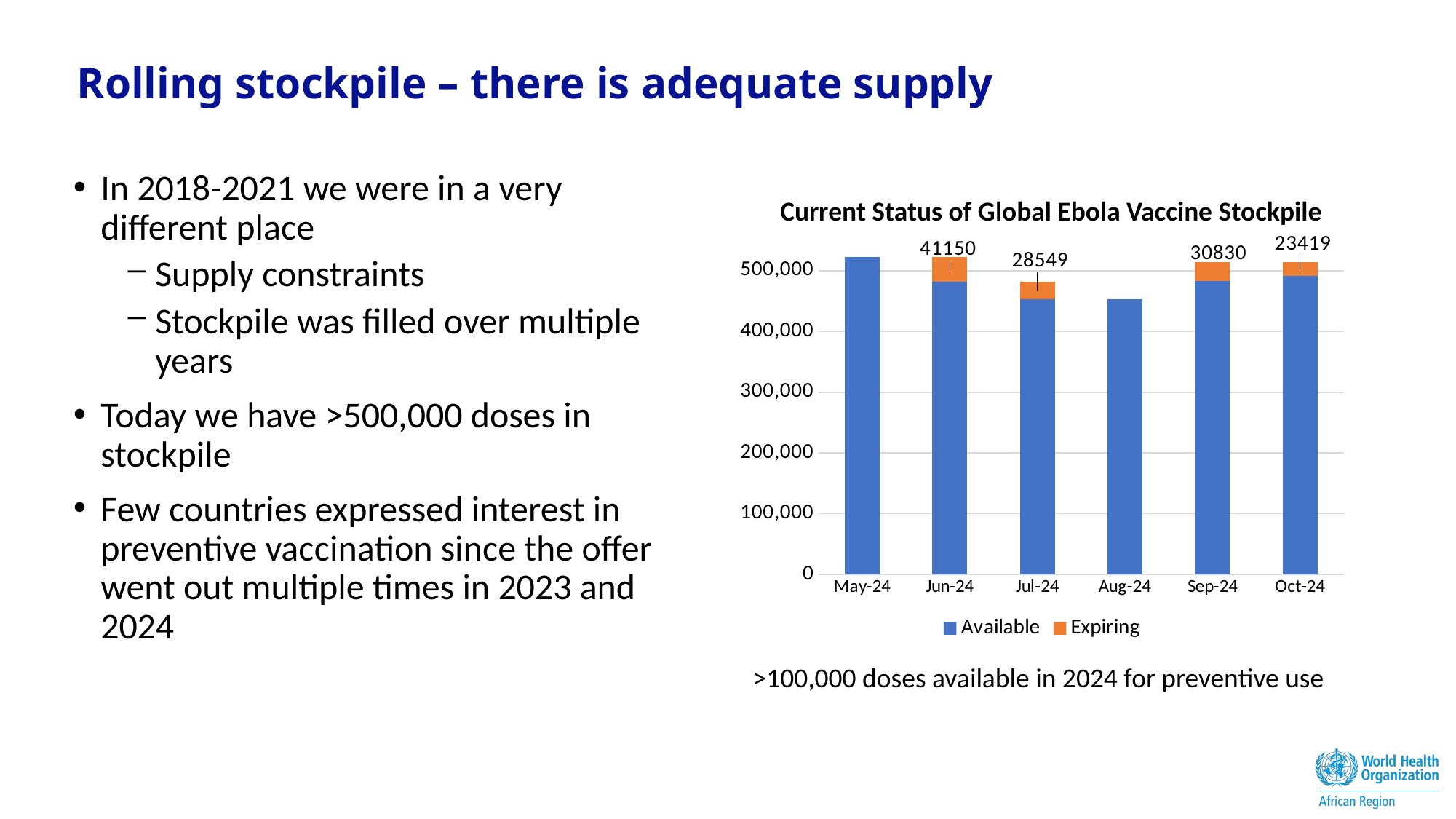
What is the difference between the Expiring values for Jun-24 and Oct-24? 17731 What is the Expiring value for Jul-24? 28549 What kind of chart is shown on the slide? bar chart Which month has the lowest labelled Expiring value? Oct-24 How many series does the chart legend list? 2 Which has the larger Expiring value, Sep-24 or Jul-24? Sep-24 How many months are shown on the x axis of the chart? 6 What is the title of the chart? Current Status of Global Ebola Vaccine Stockpile What is the Expiring value for Oct-24? 23419 Which month has the highest labelled Expiring value? Jun-24 Is the Available value for May-24 greater or less than 500,000? greater What is the Expiring value for Jun-24? 41150